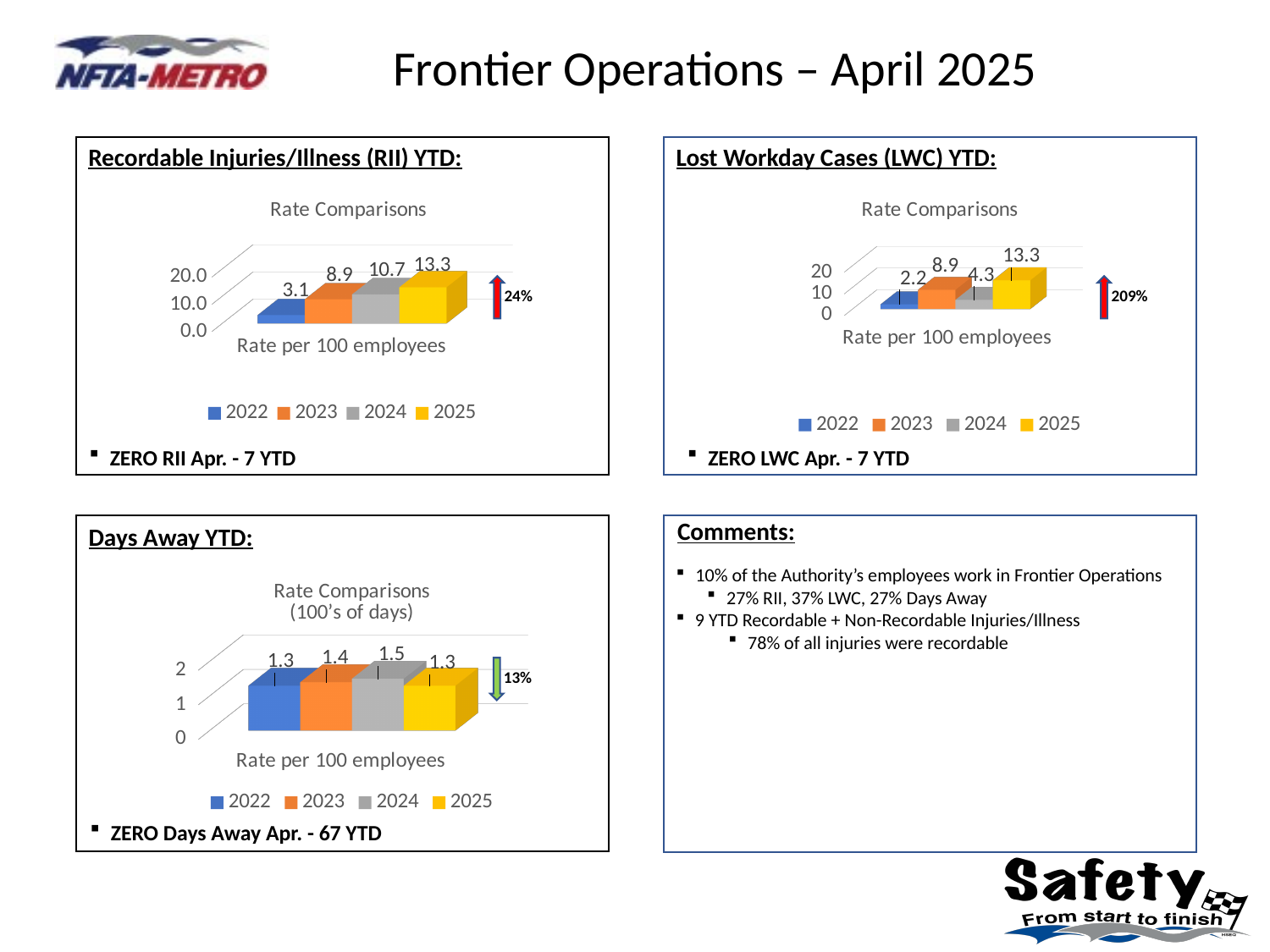
In the Lost Workday Cases (LWC) YTD chart, what is the difference between the 2025 and 2022 rates? 11.1 In the Recordable Injuries/Illness (RII) YTD chart, what is the rate per 100 employees for 2022? 3.1 In the Recordable Injuries/Illness (RII) YTD chart, what is the difference between the 2025 and 2024 rates? 2.6 In the Days Away YTD chart, what is the rate for 2024? 1.5 What kind of chart is shown in the Days Away YTD box? bar chart How many series does the legend list in the Days Away YTD chart? 4 In the Recordable Injuries/Illness (RII) YTD chart, do the rates rise or fall from 2022 to 2025? rise In the Lost Workday Cases (LWC) YTD chart, which year has the highest rate? 2025 In the Recordable Injuries/Illness (RII) YTD chart, which year has the lowest rate? 2022 In the Lost Workday Cases (LWC) YTD chart, which is larger, the 2023 rate or the 2024 rate? 2023 In the Lost Workday Cases (LWC) YTD chart, what is the rate per 100 employees for 2024? 4.3 In the Recordable Injuries/Illness (RII) YTD chart, what is the rate per 100 employees for 2025? 13.3